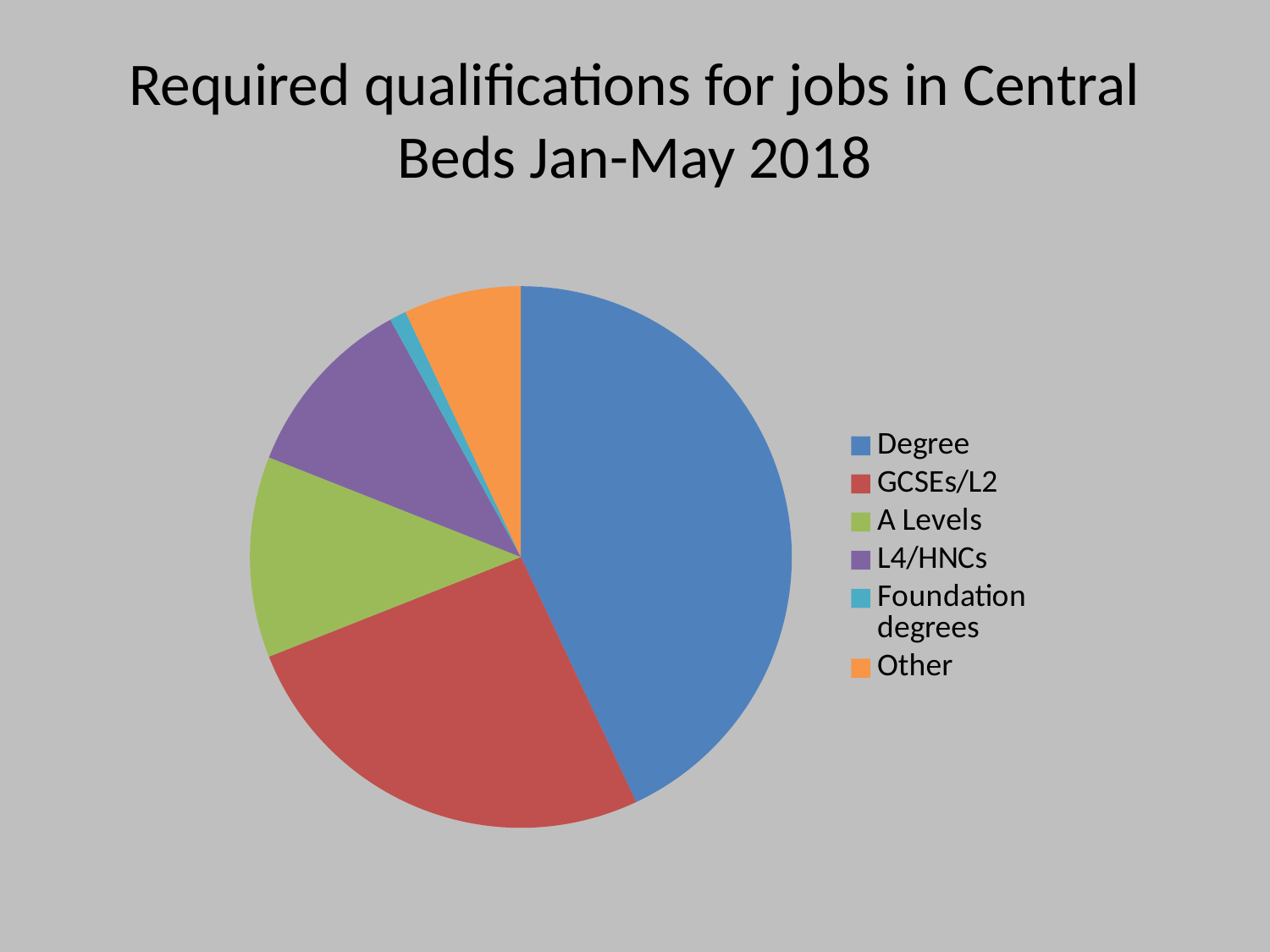
Which slice is larger, GCSEs/L2 or A Levels? GCSEs/L2 How many categories does the pie chart show? 6 Which slice is larger, Degree or GCSEs/L2? Degree Which qualification has the largest slice of the pie chart? Degree What is the title of the chart on the slide? Required qualifications for jobs in Central Beds Jan-May 2018 Which slice is larger, Other or Foundation degrees? Other What kind of chart is shown on the slide? pie chart Which qualification has the smallest slice of the pie chart? Foundation degrees What colour is the Degree slice in the pie chart? blue Which qualification has the second-largest slice of the pie chart? GCSEs/L2